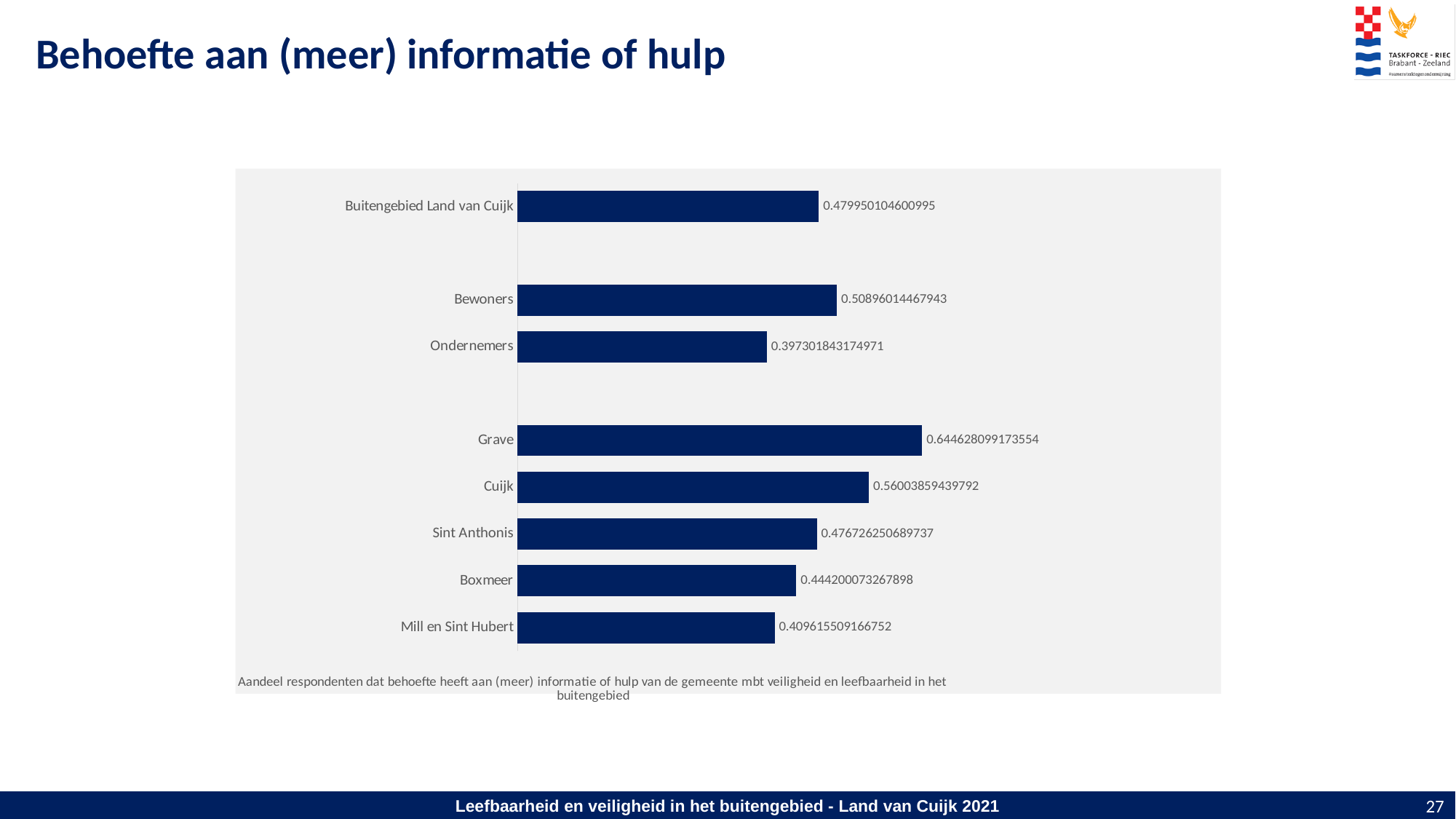
Which category has the highest value? Grave Which category has the lowest value? Ondernemers How many bars are shown in the chart? 8 What is the difference between the values for Grave and Cuijk? 0.084589504775634 What kind of chart is shown on the slide? Bar chart What is the difference between the values for Bewoners and Ondernemers? 0.111658301504459 What is the caption text shown below the bars of the chart? Aandeel respondenten dat behoefte heeft aan (meer) informatie of hulp van de gemeente mbt veiligheid en leefbaarheid in het buitengebied What is the value for Mill en Sint Hubert? 0.409615509166752 What is the value for Grave? 0.644628099173554 Which is larger, the value for Cuijk or the value for Boxmeer? Cuijk What is the value for Ondernemers? 0.397301843174971 What is the value for Buitengebied Land van Cuijk? 0.479950104600995